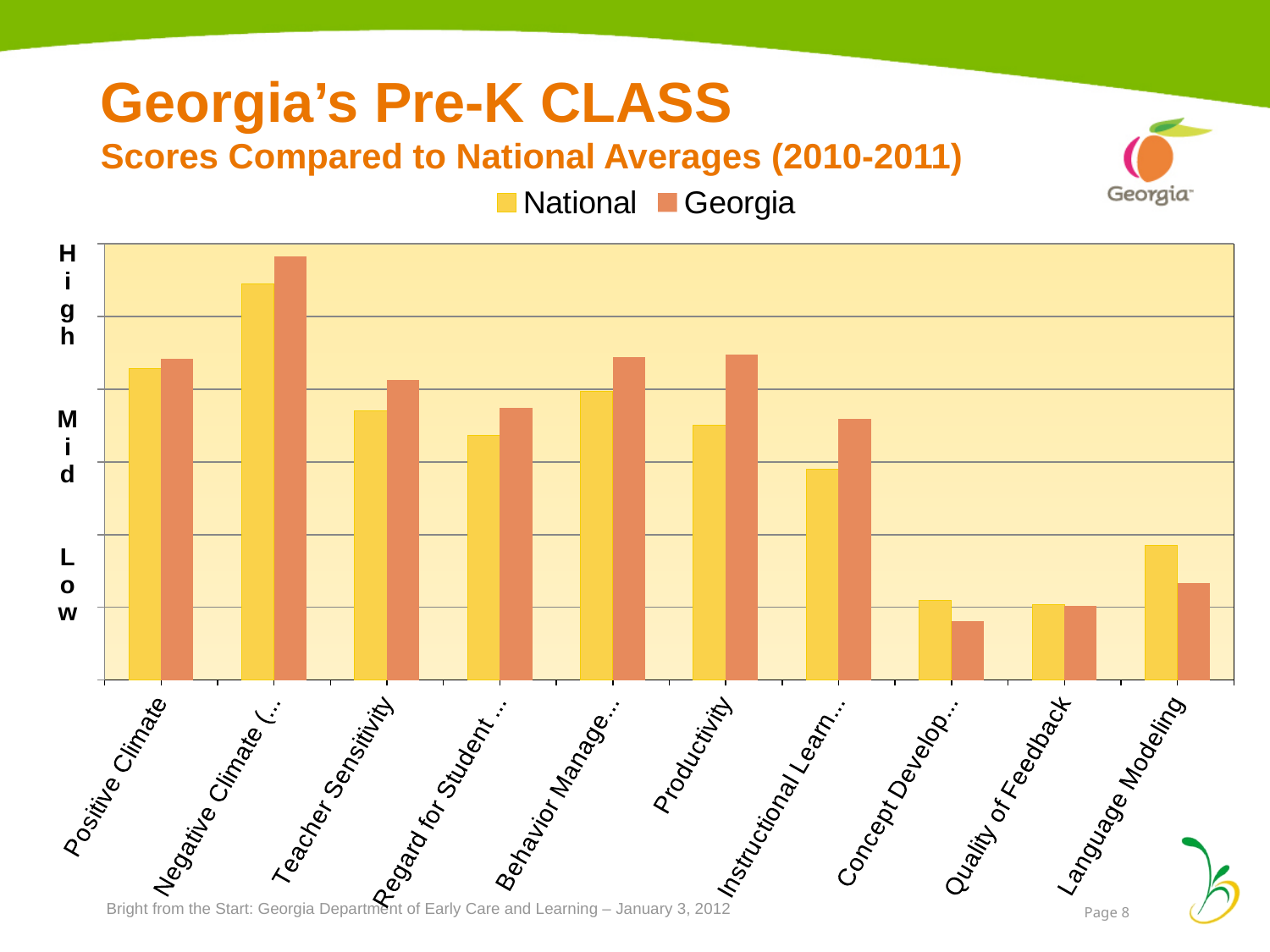
For Language Modeling, which is higher, the National bar or the Georgia bar? National For Concept Development, which is higher, the National bar or the Georgia bar? National Which category has the lowest Georgia bar? Concept Development Which category has the highest Georgia bar? Negative Climate What colour are the Georgia bars? orange What are the two series named in the legend? National and Georgia How many series does the legend list? 2 For Teacher Sensitivity, which is higher, the National bar or the Georgia bar? Georgia How many categories are plotted along the x axis? 10 Which category has the highest National bar? Negative Climate What kind of chart is shown on the slide? bar chart